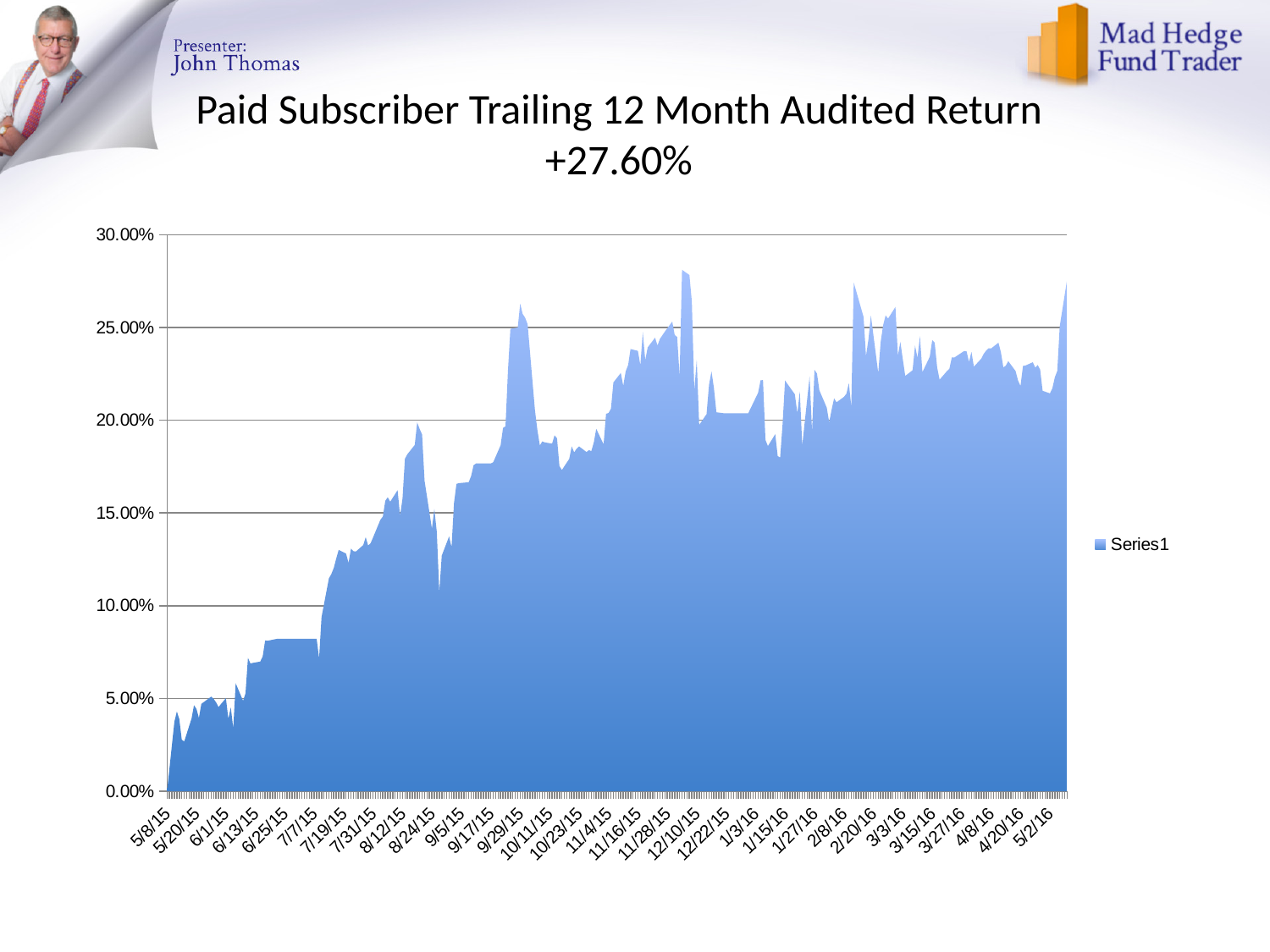
How many series does the legend list? 1 Do the values generally rise or fall from 5/8/15 to 5/2/16? Rise Is the value at 6/25/15 greater or less than 10.00%? less Is the value at 5/8/15 greater or less than 5.00%? less What is the title of the chart on the slide? Paid Subscriber Trailing 12 Month Audited Return +27.60% Is the value at 11/16/15 greater or less than 20.00%? greater What kind of chart is shown on the slide? Area chart What is the name of the series shown in the legend? Series1 Which is larger, the value at 5/20/15 or the value at 7/31/15? 7/31/15